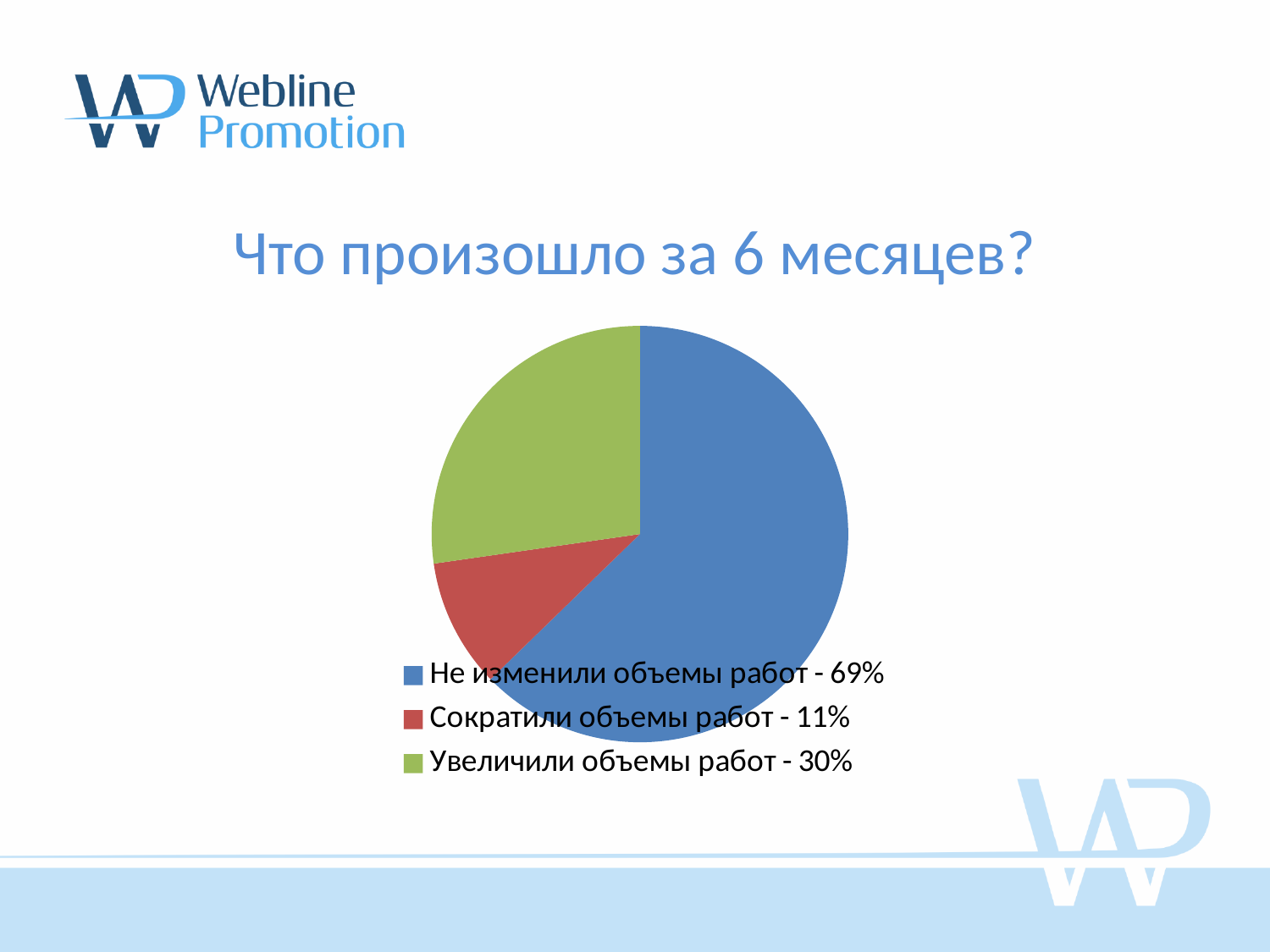
Which is larger: the share for "Увеличили объемы работ" or the share for "Сократили объемы работ"? Увеличили объемы работ What kind of chart is shown on the slide? pie chart What share of the pie is labelled "Не изменили объемы работ"? 69% What is the title of the slide above the pie chart? Что произошло за 6 месяцев? What colour is the slice for "Сократили объемы работ"? red Which category has the smallest slice of the pie? Сократили объемы работ What share of the pie is labelled "Увеличили объемы работ"? 30% What share of the pie is labelled "Сократили объемы работ"? 11% How many slices does the pie chart have? 3 What is the difference in percentage points between "Увеличили объемы работ" and "Сократили объемы работ"? 19 Which category has the largest slice of the pie? Не изменили объемы работ What is the difference in percentage points between "Не изменили объемы работ" and "Увеличили объемы работ"? 39